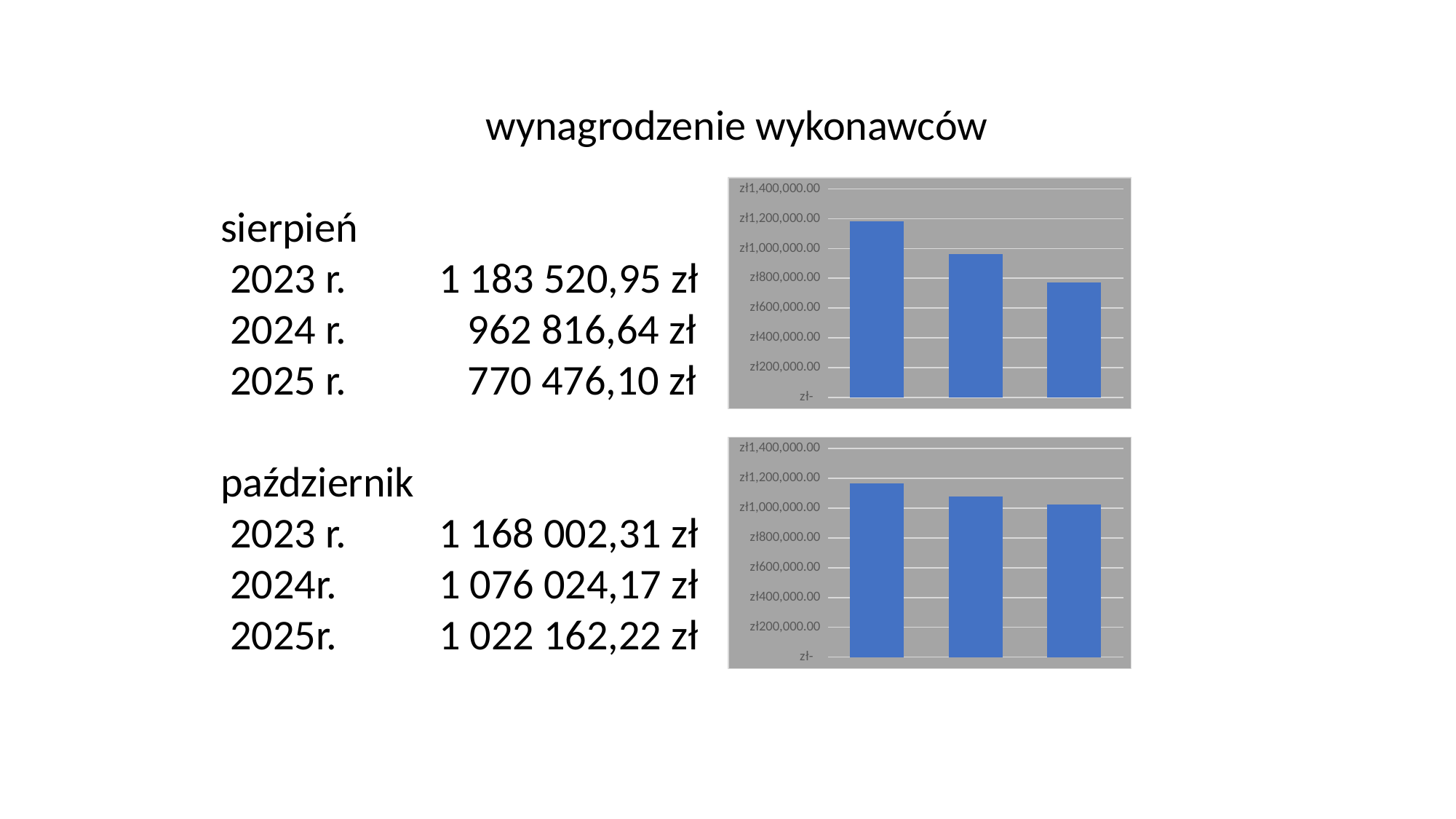
How many bars does the bottom chart show? 3 In the top chart, is the value of the third (rightmost) bar greater or less than zł800,000.00? less What is the highest value shown on the vertical axis of the top chart? zł1,400,000.00 What kind of chart is the top chart on the slide? bar chart In the bottom chart, which bar is the tallest? the first (leftmost) bar In the top chart, do the bar values rise or fall from left to right? fall In the top chart, which bar is the shortest? the third (rightmost) bar In the bottom chart, is the value of the first (leftmost) bar greater or less than zł1,000,000.00? greater How many bars does the top chart show? 3 In the top chart, is the value of the first (leftmost) bar greater or less than zł1,000,000.00? greater According to the slide, what is the difference between the sierpień values for 2023 r. and 2025 r.? 413 044,85 zł According to the slide, what was the wynagrodzenie wykonawców for sierpień 2023 r.? 1 183 520,95 zł